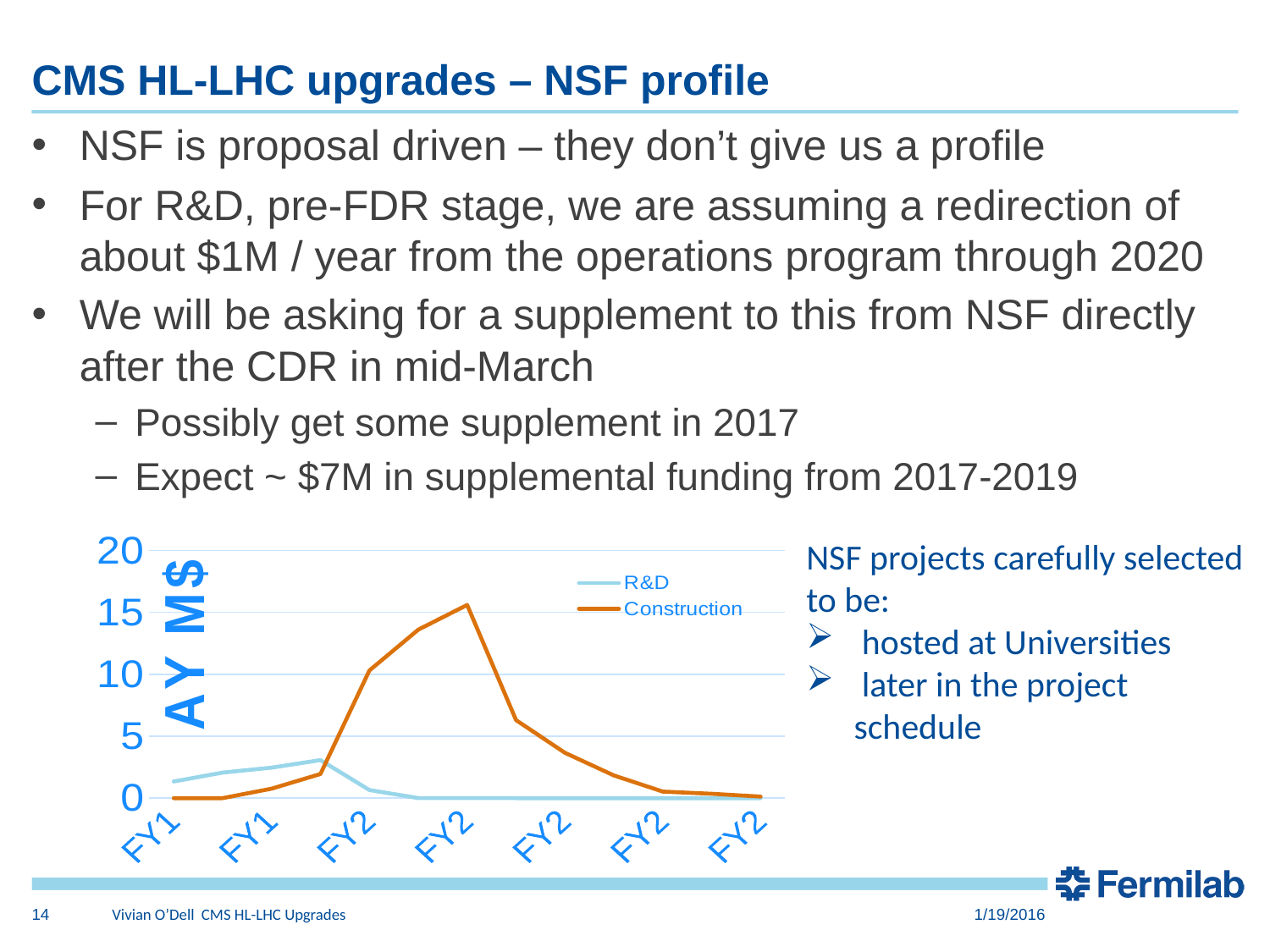
What is the title of the chart's vertical axis? AY M$ Does the R&D series rise or fall between its peak and the last point on the x axis? fall What kind of chart is shown on the slide? line chart Is the peak value of the R&D series greater or less than 5? less Is the value of the Construction series at the last point on the x axis greater or less than 5? less Is the value of the Construction series at the first point on the x axis greater or less than 5? less How many labelled points are there along the x axis of the chart? 7 Which series reaches the higher peak value, R&D or Construction? Construction What is the highest tick value shown on the chart's vertical axis? 20 What are the two series named in the chart legend? R&D and Construction How many series does the chart legend list? 2